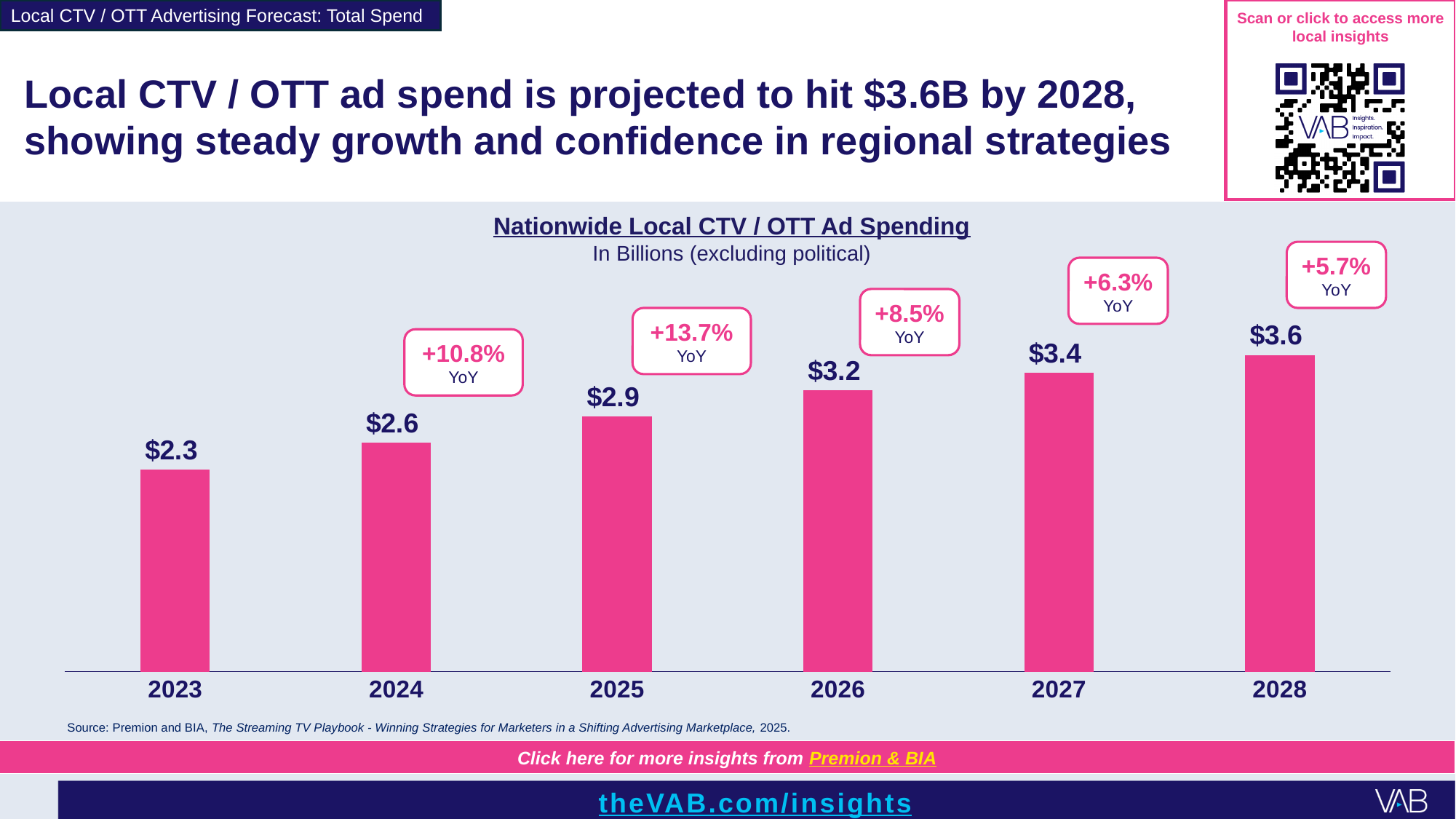
Which year shows the smallest year-over-year growth percentage? 2028 What is the local CTV / OTT ad spending value shown for 2023? $2.3 Which year has the highest local CTV / OTT ad spending? 2028 What kind of chart is used to show the ad spending? Bar chart How many years are shown on the x axis of the chart? 6 What is the projected local CTV / OTT ad spending for 2028? $3.6 Which year has the lowest local CTV / OTT ad spending? 2023 What is the difference in ad spending between 2028 and 2023? $1.3 Which year has higher ad spending, 2025 or 2027? 2027 What is the year-over-year growth shown for 2025? +13.7% What is the title of the chart? Nationwide Local CTV / OTT Ad Spending Do the ad spending values rise or fall from 2023 to 2028? Rise